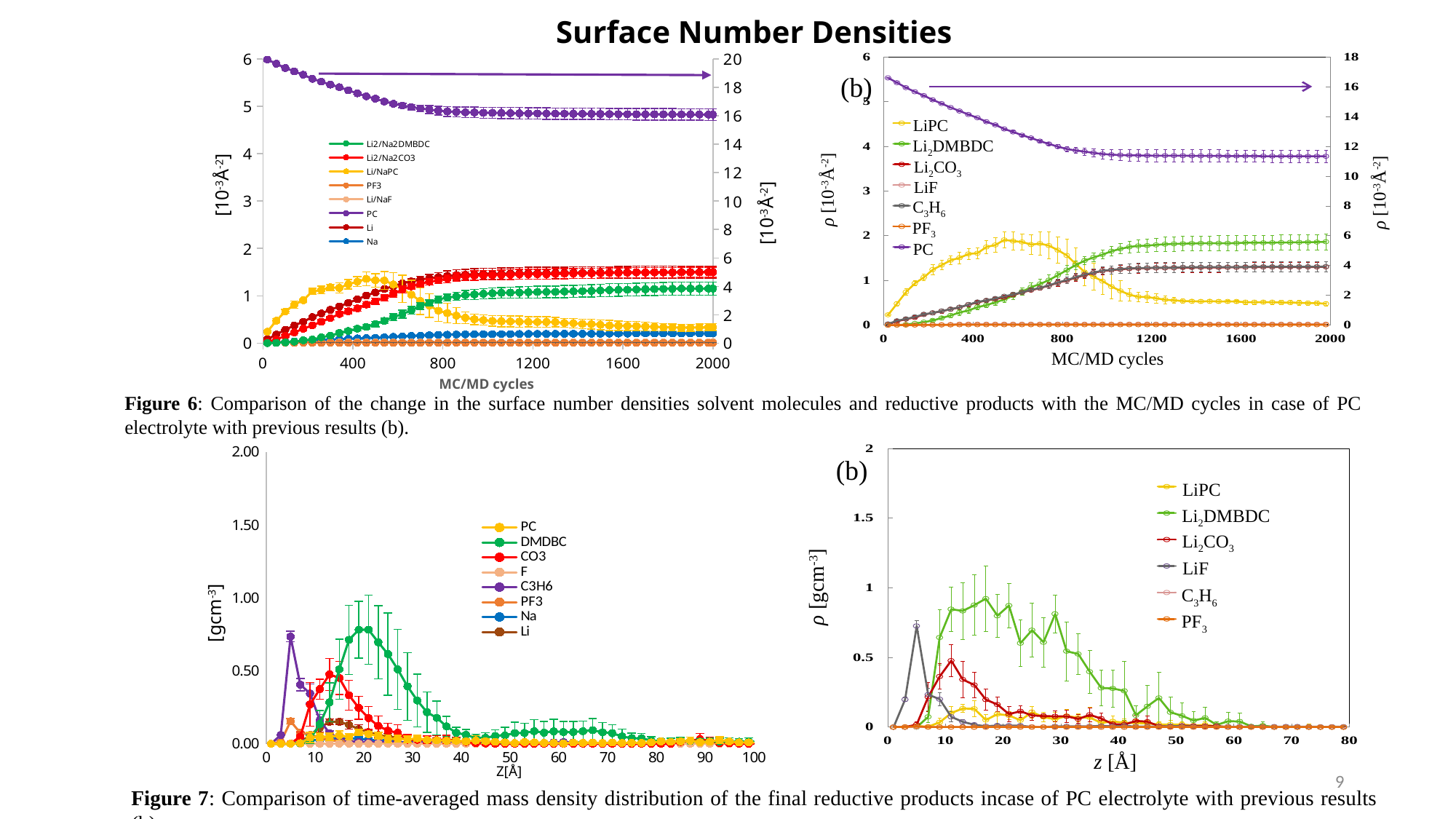
In the top-right chart labelled (b), at 2000 MC/MD cycles, which is larger: Li2DMBDC or Li2CO3? Li2DMBDC What is the title of the slide's charts? Surface Number Densities In the top-right chart labelled (b), does the PC series rise or fall as the MC/MD cycles increase? fall In the top-right chart labelled (b), is the Li2DMBDC value at 2000 MC/MD cycles greater or less than 1 on the left axis? greater In the bottom-right chart labelled (b), how many series does the legend list? 6 In the bottom-right chart labelled (b), which series reaches the higher peak: Li2DMBDC or LiF? Li2DMBDC In the top-left chart, does the PC series rise or fall as the MC/MD cycles increase? fall In the top-right chart labelled (b), how many series does the legend list? 7 In the bottom-left chart, how many series does the legend list? 8 What kind of chart is the top-right chart labelled (b)? line chart In the bottom-right chart labelled (b), is the peak value of Li2DMBDC greater or less than 0.5? greater